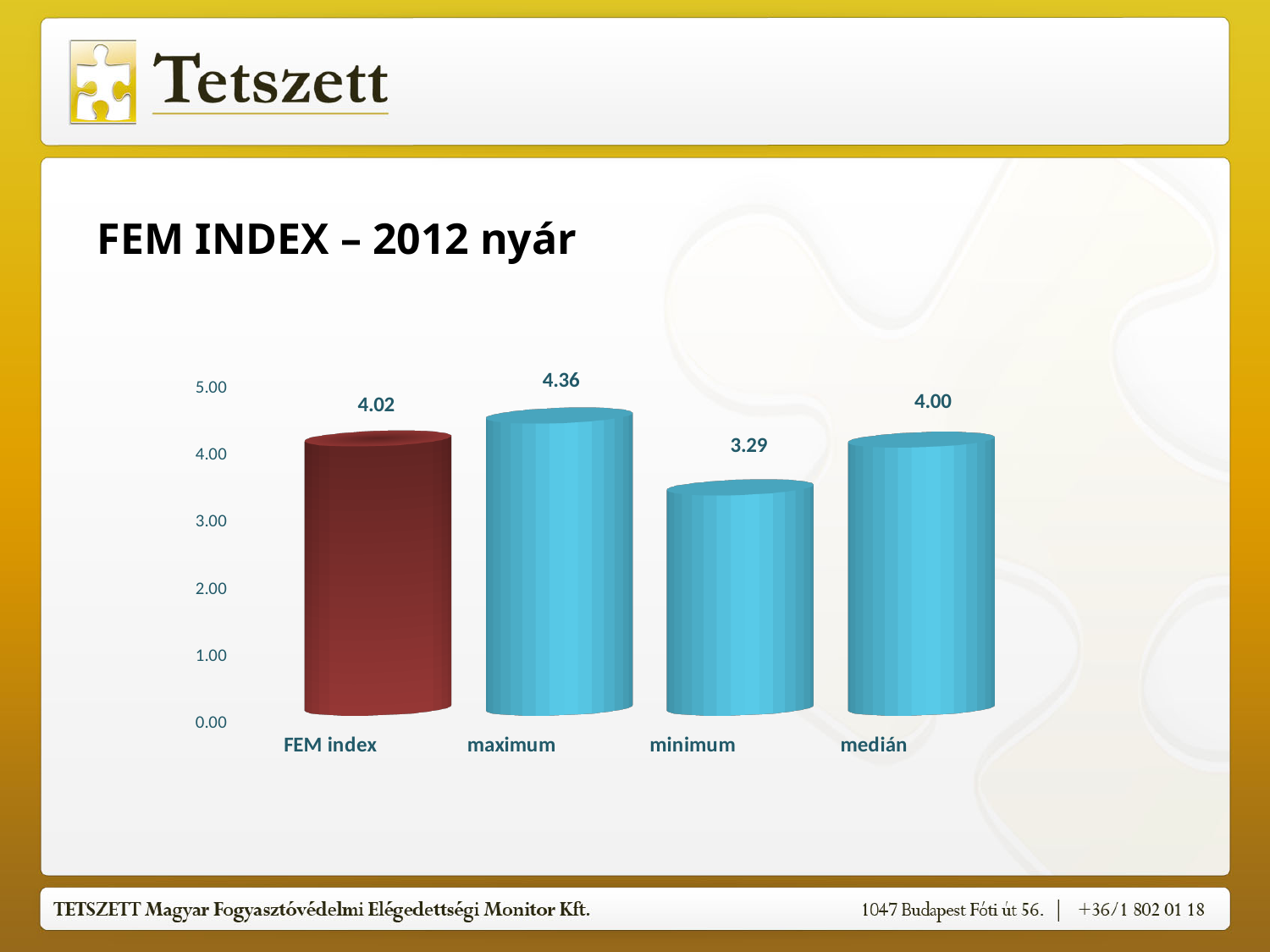
What is the value for minimum? 3.29 Which category has the highest value? maximum What is the difference between the maximum and minimum values? 1.07 Which category has the lowest value? minimum What is the value for FEM index? 4.02 What is the difference between the FEM index and the medián? 0.02 How many categories are shown on the chart? 4 What is the title of the slide containing the chart? FEM INDEX – 2012 nyár What is the value for maximum? 4.36 What is the value for medián? 4.00 Which is larger, the value for FEM index or the value for minimum? FEM index What kind of chart is shown on the slide? bar chart